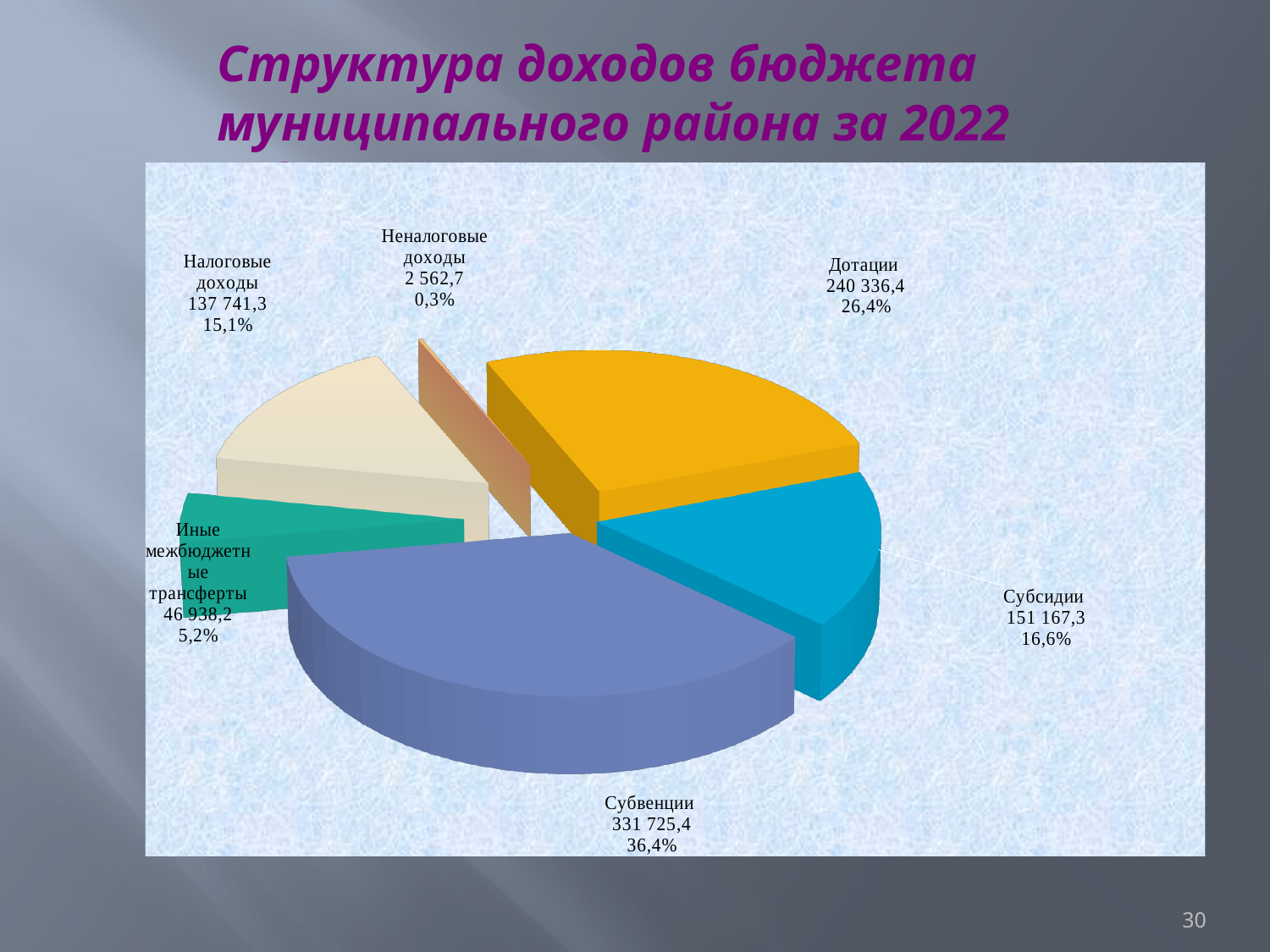
What share of the pie does Дотации represent? 26,4% What is the value shown for Иные межбюджетные трансферты? 46 938,2 Which is larger, Субсидии or Налоговые доходы? Субсидии What is the value shown for Субвенции? 331 725,4 What percentage is shown for Неналоговые доходы? 0,3% What is the difference in percentage points between Субвенции and Дотации? 10,0% Which category has the smallest slice of the pie? Неналоговые доходы What type of chart is shown on the slide? Pie chart How many slices does the pie chart have? 6 What is the title of the slide containing the chart? Структура доходов бюджета муниципального района за 2022 What is the value shown for Налоговые доходы? 137 741,3 Which category has the largest slice of the pie? Субвенции